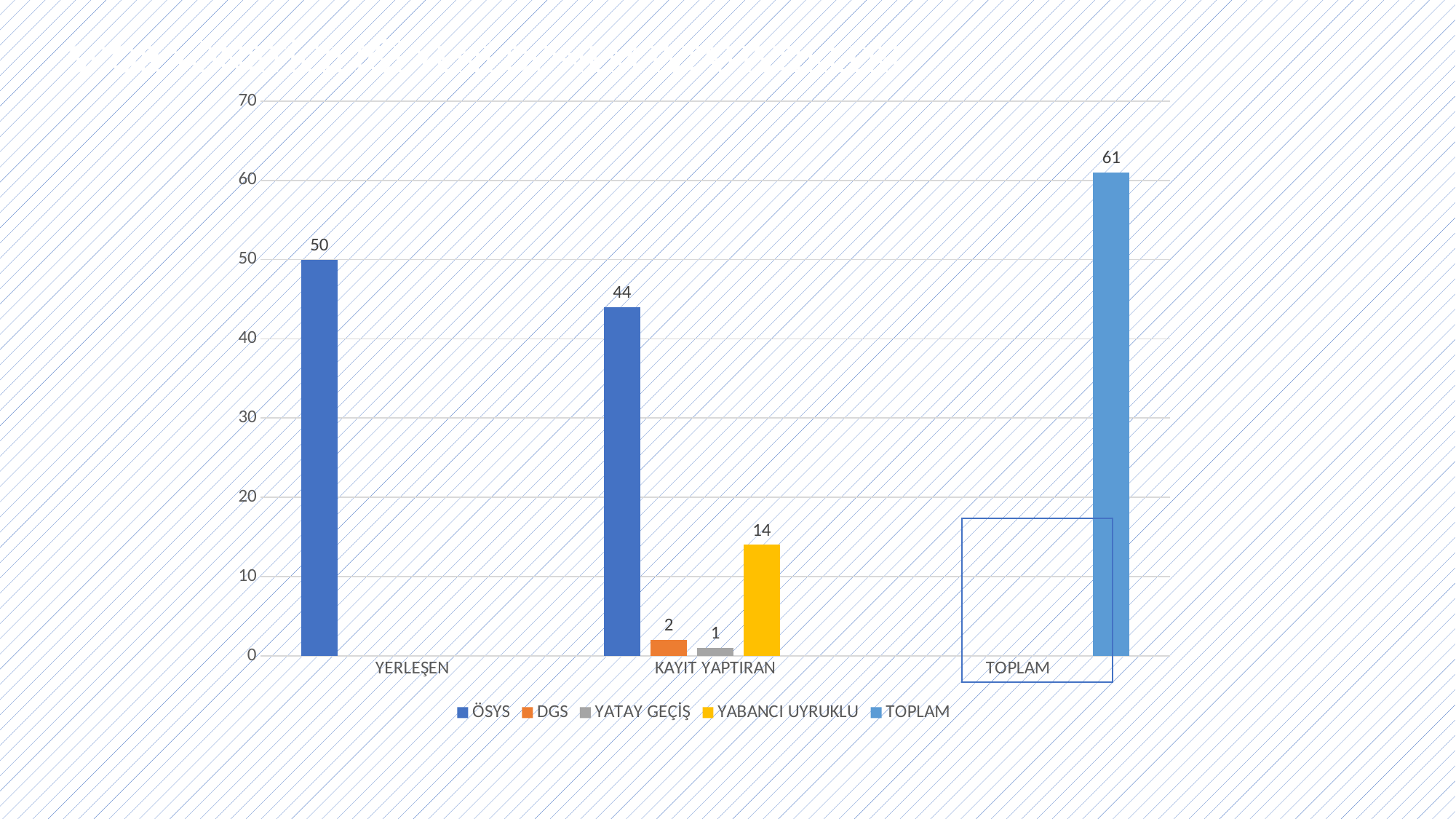
What is the YATAY GEÇİŞ value for KAYIT YAPTIRAN? 1 What is the TOPLAM value shown for the TOPLAM category? 61 Which is larger: the YABANCI UYRUKLU value for KAYIT YAPTIRAN or the DGS value for KAYIT YAPTIRAN? YABANCI UYRUKLU What is the YABANCI UYRUKLU value for KAYIT YAPTIRAN? 14 What kind of chart is shown on the slide? Bar chart What is the difference between the ÖSYS value for YERLEŞEN and the ÖSYS value for KAYIT YAPTIRAN? 6 What is the DGS value for KAYIT YAPTIRAN? 2 Which series has the lowest value in the KAYIT YAPTIRAN category? YATAY GEÇİŞ How many series does the legend list? 5 What is the ÖSYS value for YERLEŞEN? 50 What is the ÖSYS value for KAYIT YAPTIRAN? 44 How many categories are shown on the x axis? 3